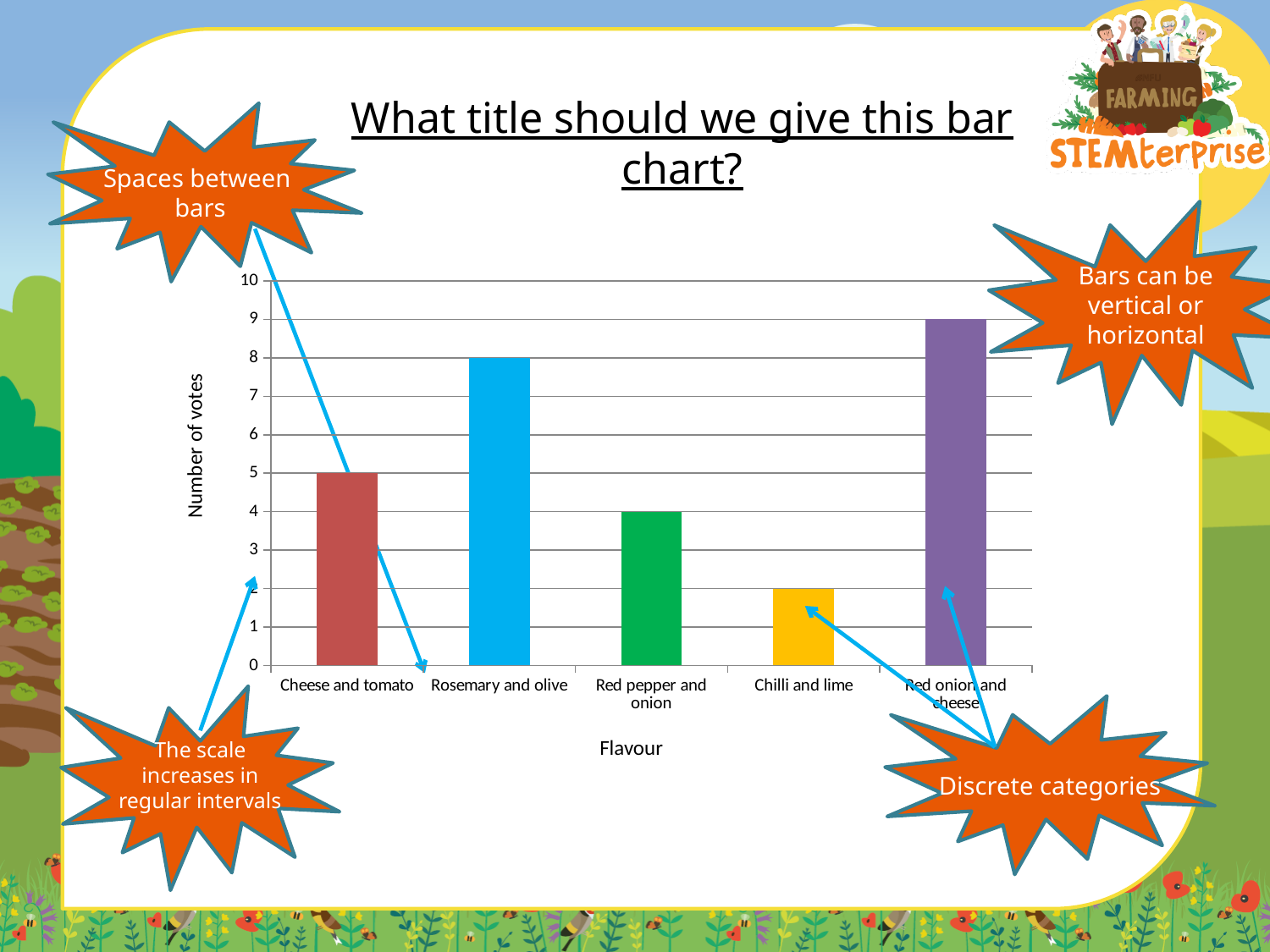
What is the difference in votes between Red onion and cheese and Red pepper and onion? 5 How many votes did Rosemary and olive receive? 8 How many flavours are shown on the x axis? 5 How many votes did Cheese and tomato receive? 5 What is the label of the vertical axis? Number of votes Which received more votes, Rosemary and olive or Cheese and tomato? Rosemary and olive Is the value for Red pepper and onion greater or less than 5? less Which flavour received the most votes? Red onion and cheese What kind of chart is shown on the slide? bar chart Which flavour received the fewest votes? Chilli and lime How many votes did Chilli and lime receive? 2 What is the label of the horizontal axis? Flavour